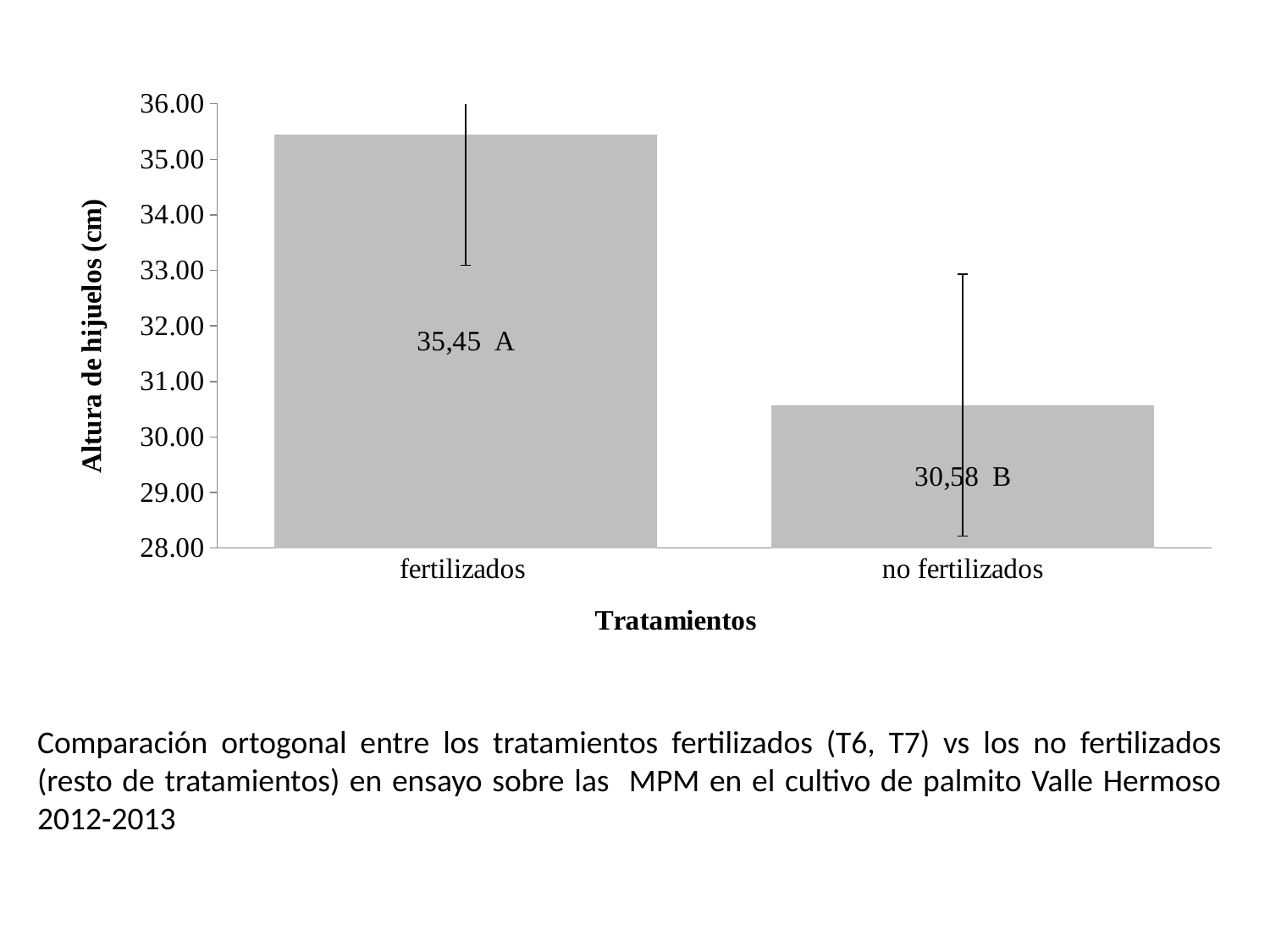
Which is larger, the value for fertilizados or for no fertilizados? fertilizados How many categories are shown on the x axis? 2 Which treatment has the highest altura de hijuelos? fertilizados What is the value shown for the no fertilizados bar? 30,58 What is the difference between the fertilizados and no fertilizados values? 4,87 What is the label of the y axis? Altura de hijuelos (cm) What is the value shown for the fertilizados bar? 35,45 Is the value for fertilizados greater or less than 35.00? greater What is the label of the x axis? Tratamientos Which treatment has the lowest altura de hijuelos? no fertilizados Is the value for no fertilizados greater or less than 31.00? less What kind of chart is shown on the slide? bar chart